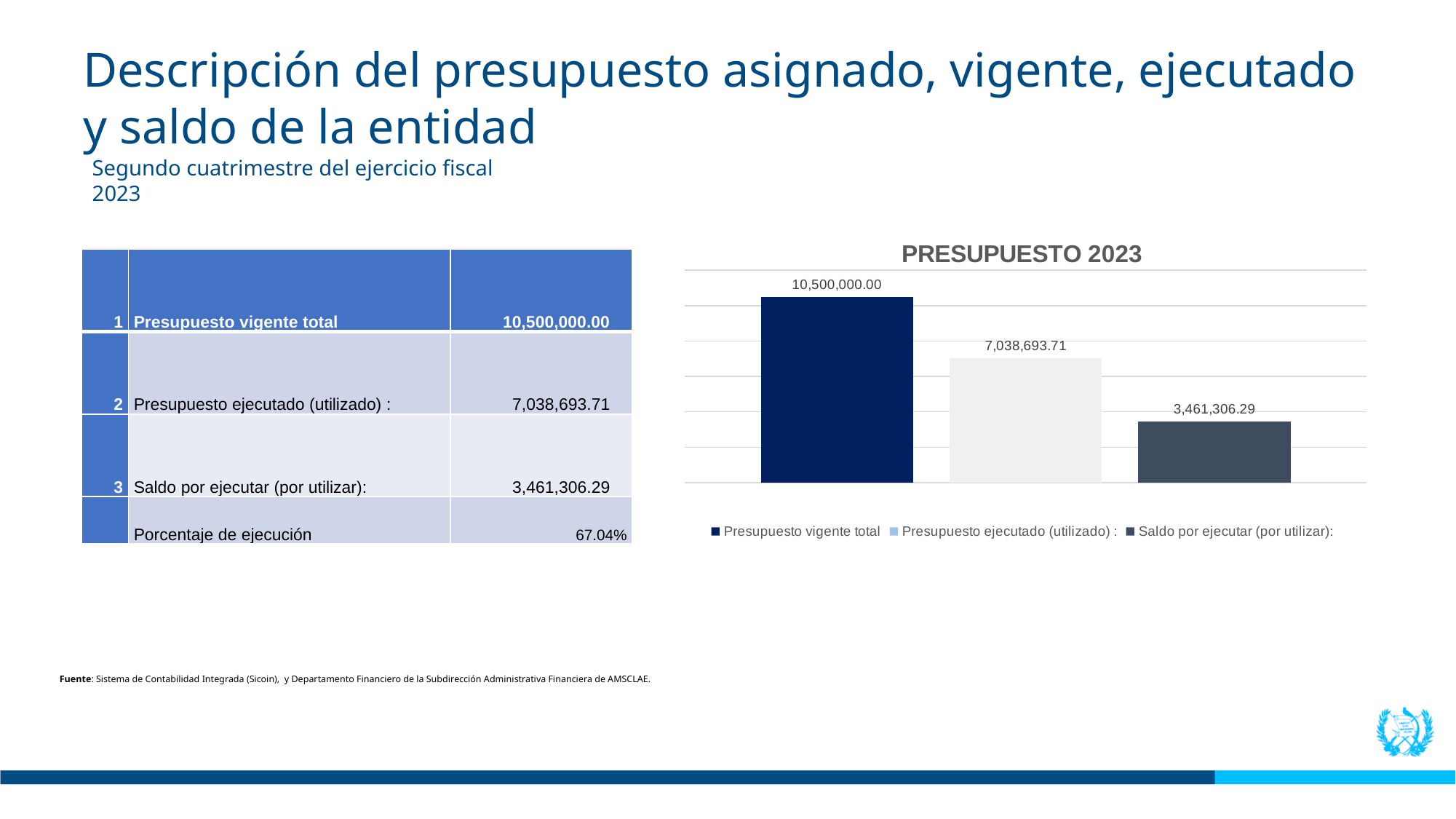
How many series does the legend list? 3 What is the title of the chart? PRESUPUESTO 2023 Which series has the lowest value in the chart? Saldo por ejecutar (por utilizar) What is the difference between Presupuesto vigente total and Presupuesto ejecutado (utilizado)? 3,461,306.29 What is the difference between Presupuesto ejecutado (utilizado) and Saldo por ejecutar (por utilizar)? 3,577,387.42 What is the value of the Saldo por ejecutar (por utilizar) bar? 3,461,306.29 How many bars are plotted in the chart? 3 What is the value of the Presupuesto ejecutado (utilizado) bar? 7,038,693.71 Which series has the highest value in the chart? Presupuesto vigente total What is the value of the Presupuesto vigente total bar? 10,500,000.00 What kind of chart is shown on the slide? Bar chart Which is larger, Presupuesto ejecutado (utilizado) or Saldo por ejecutar (por utilizar)? Presupuesto ejecutado (utilizado)